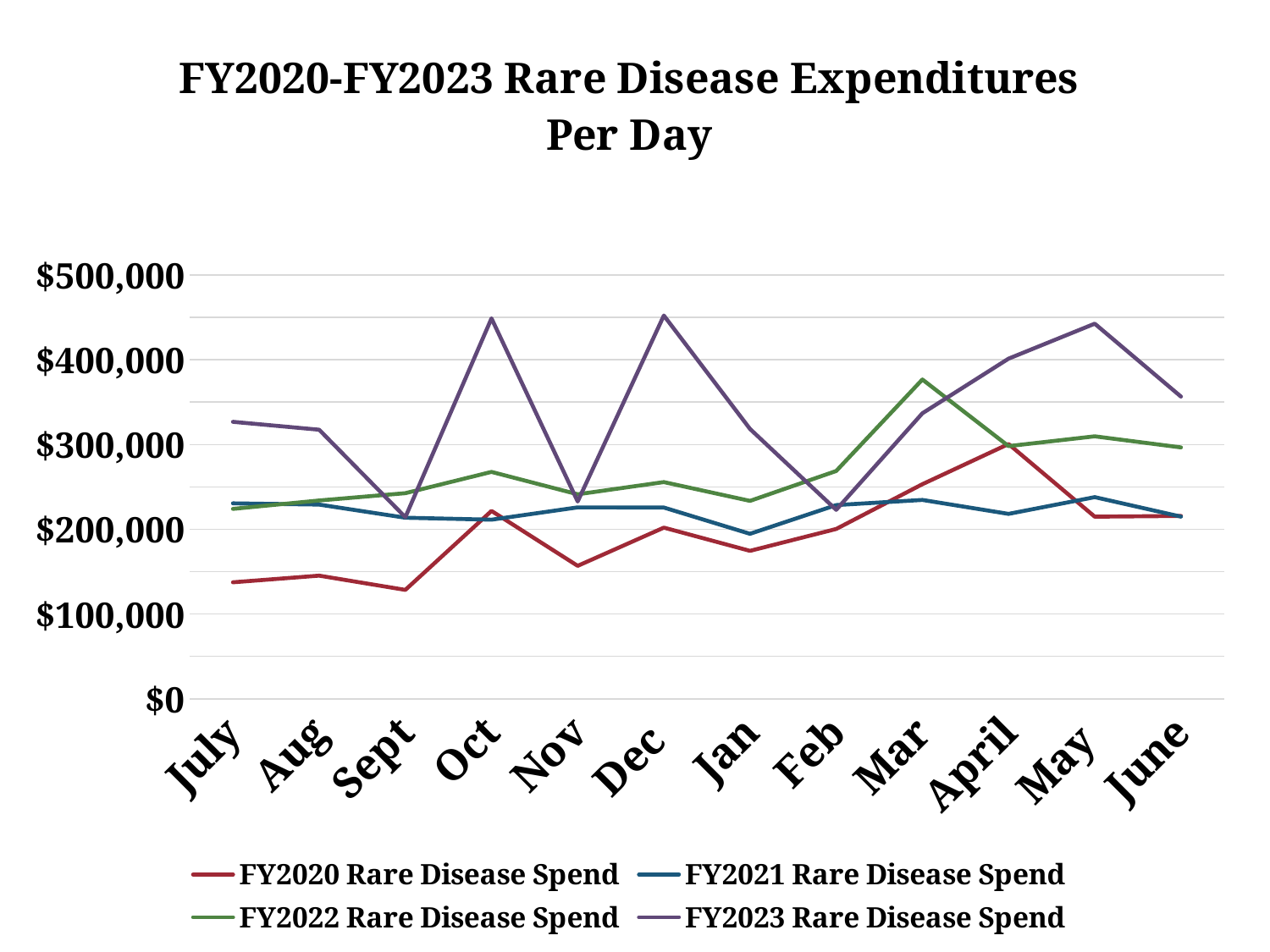
What type of chart is shown on the slide? line chart Is the FY2020 Rare Disease Spend value for Sept greater or less than $200,000? less Does the FY2023 Rare Disease Spend rise or fall from Sept to Oct? rise In which month is the FY2020 Rare Disease Spend highest? April In which month is the FY2022 Rare Disease Spend highest? Mar Is the FY2022 Rare Disease Spend value for Mar greater or less than $300,000? greater In Oct, which is larger: FY2023 Rare Disease Spend or FY2021 Rare Disease Spend? FY2023 Rare Disease Spend Is the FY2023 Rare Disease Spend value for Oct greater or less than $400,000? greater What is the title of the chart? FY2020-FY2023 Rare Disease Expenditures Per Day How many series does the legend list? 4 How many months are shown along the x axis? 12